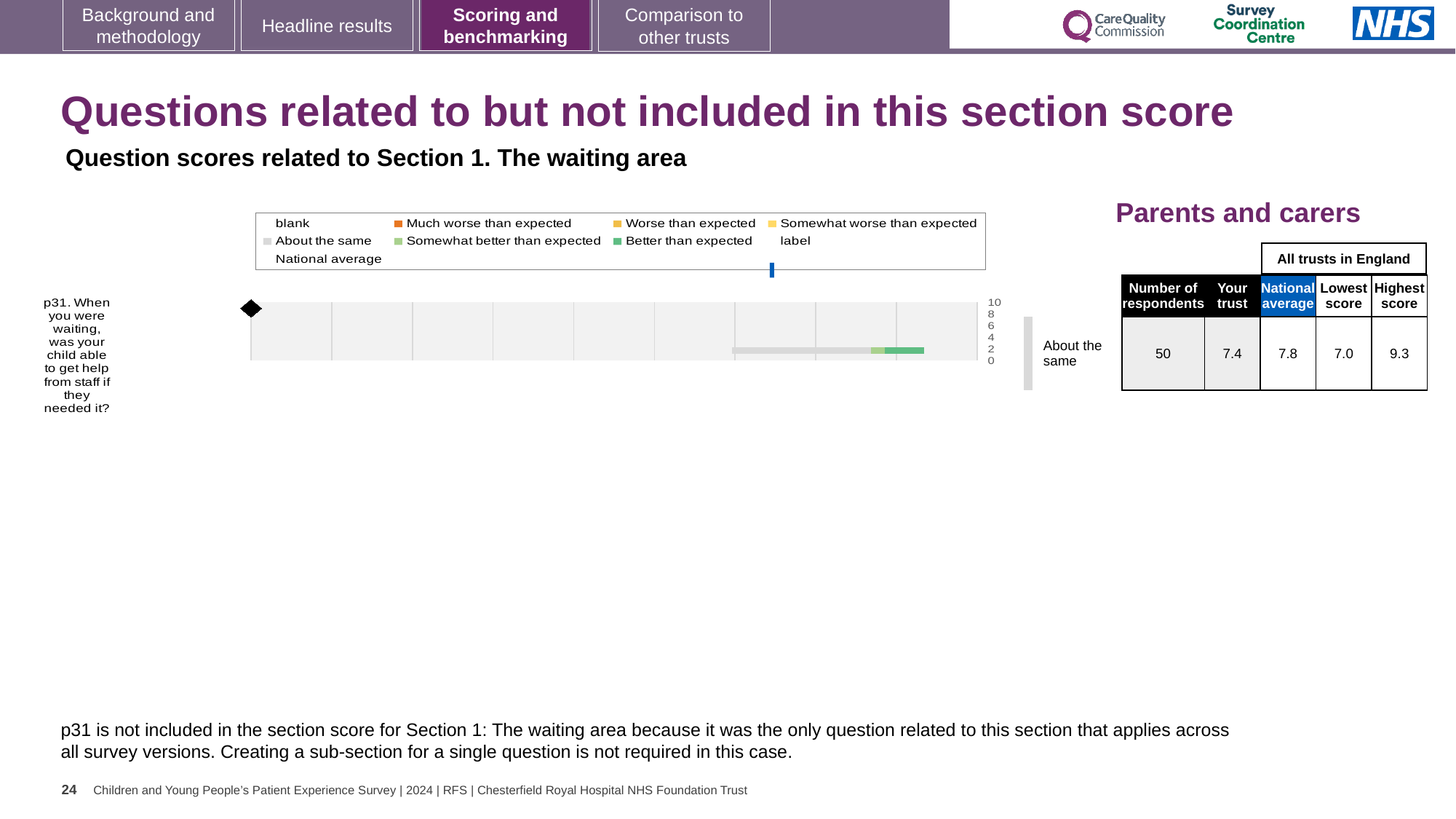
What is the national average score for p31? 7.8 How many questions are plotted on the chart? 1 What benchmark category is shown next to the bar for p31? About the same What is the highest score among all trusts in England for p31? 9.3 What is the 'Your trust' score for p31? 7.4 Which is higher for p31, the 'Your trust' score or the national average? National average What is the lowest score among all trusts in England for p31? 7.0 What kind of chart is used to show the score for question p31? bar chart By how much does the national average exceed the 'Your trust' score for p31? 0.4 What is the maximum value shown on the chart's score axis? 10 How many respondents answered question p31? 50 What is the difference between the highest score and the lowest score for p31? 2.3